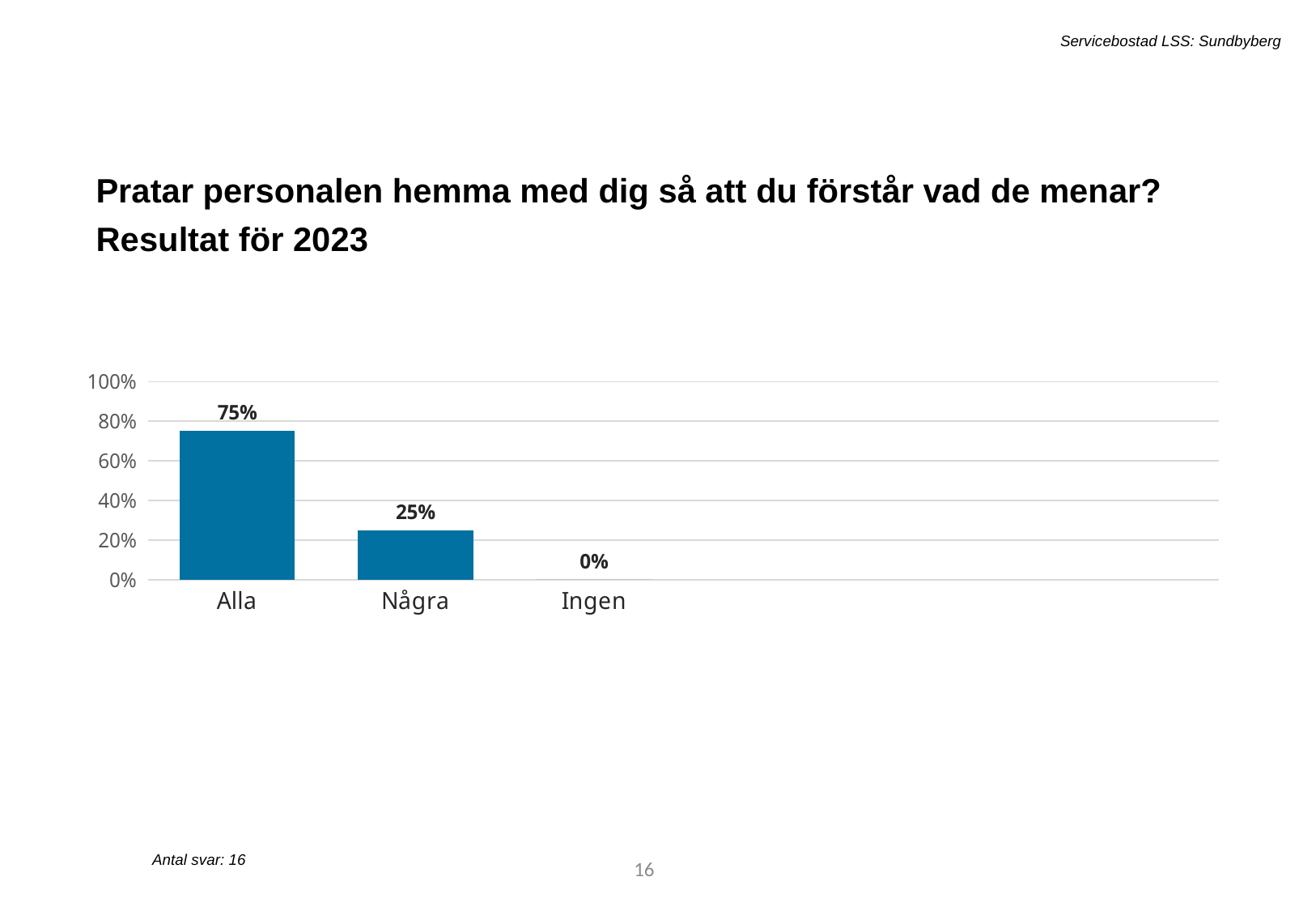
Is the value for Alla greater or less than 60%? greater What is the difference between the values for Alla and Några? 50% Do the values rise or fall from left to right along the x axis? fall Which category has the highest value? Alla What is the value for Ingen? 0% Which category has the lowest value? Ingen How many categories are shown on the x axis? 3 What kind of chart is shown on the slide? bar chart Which is larger, the value for Några or the value for Ingen? Några What is the number of responses (Antal svar) stated on the slide? 16 What is the value for Några? 25% What is the value for Alla? 75%